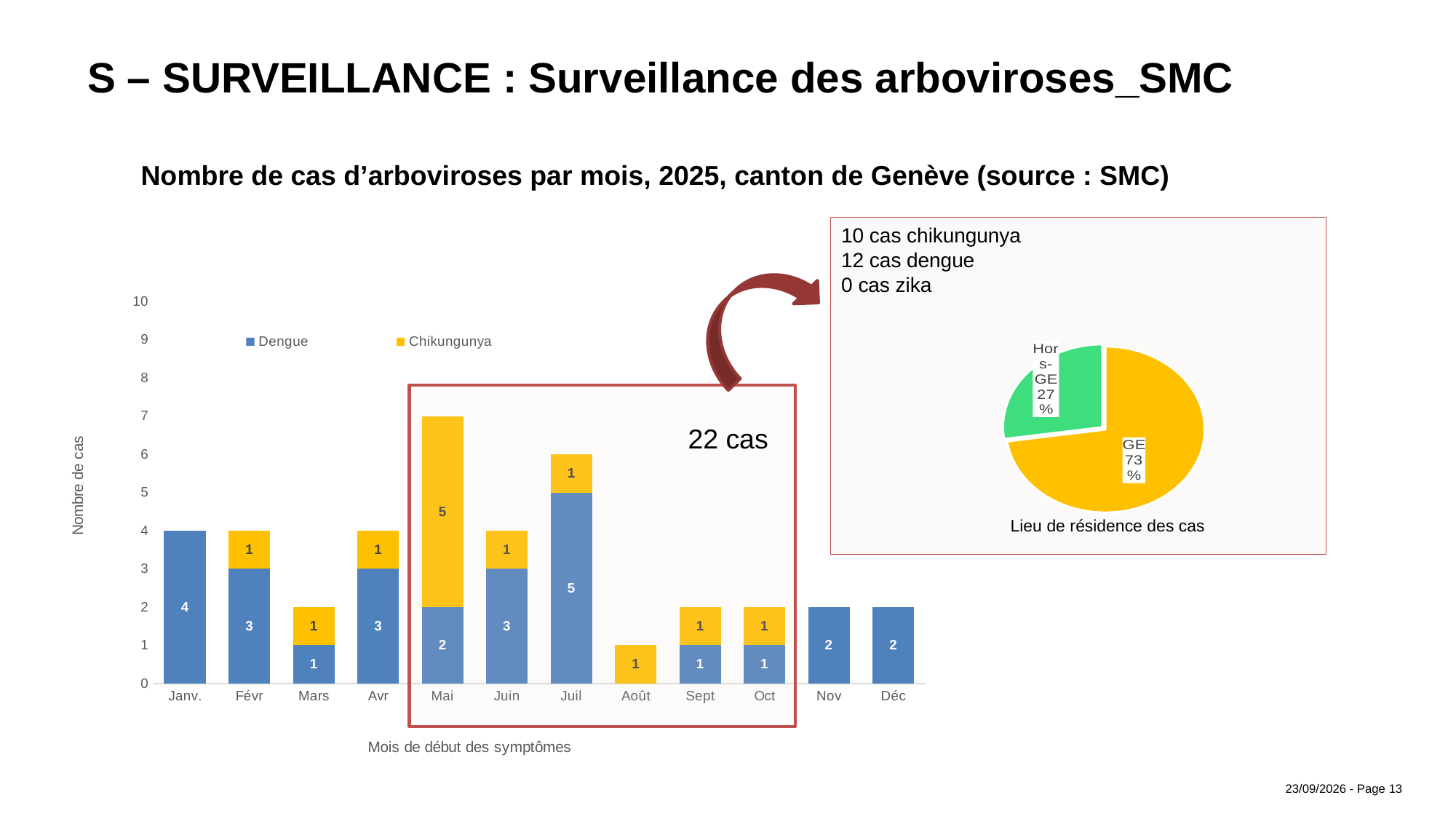
In the pie chart 'Lieu de résidence des cas', what share does GE have? 73% What kind of chart is the chart titled 'Lieu de résidence des cas'? Pie chart In the bar chart, what is the Chikungunya value for Mai? 5 In the bar chart, which month has the highest Dengue value? Juil In the bar chart, what is the difference between the Chikungunya value for Mai and the Chikungunya value for Juin? 4 In the bar chart, what is the total of the stacked bar for Juil? 6 In the bar chart, what is the total of the stacked bar for Mai? 7 In the bar chart, what is the Dengue value for Juil? 5 How many series does the legend of the bar chart list? 2 In the bar chart, which is larger: the Dengue value for Avr or the Dengue value for Mars? Avr In the bar chart, what is the Dengue value for Janv.? 4 In the bar chart, which month has the highest Chikungunya value? Mai